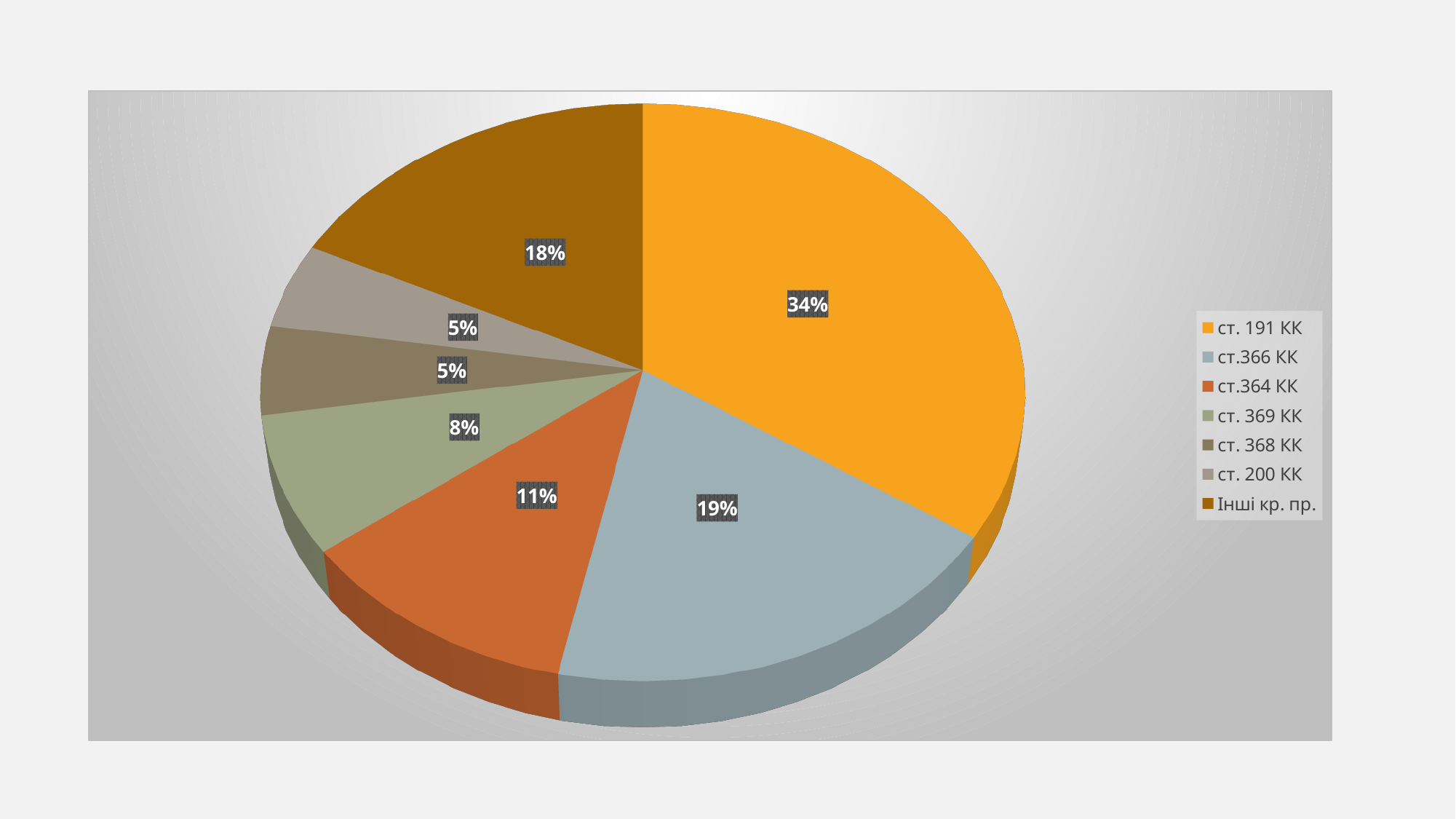
Which category has the largest slice of the pie? ст. 191 КК What share of the pie does ст.366 КК have? 19% Which is larger, the slice for ст.364 КК or the slice for Інші кр. пр.? Інші кр. пр. How many entries does the legend list? 7 What colour is the slice for ст. 191 КК? orange What share of the pie does Інші кр. пр. have? 18% How many slices does the pie chart have? 7 What share of the pie does ст. 369 КК have? 8% What kind of chart is shown on the slide? pie chart What is the difference in percentage points between ст. 191 КК and ст.366 КК? 15